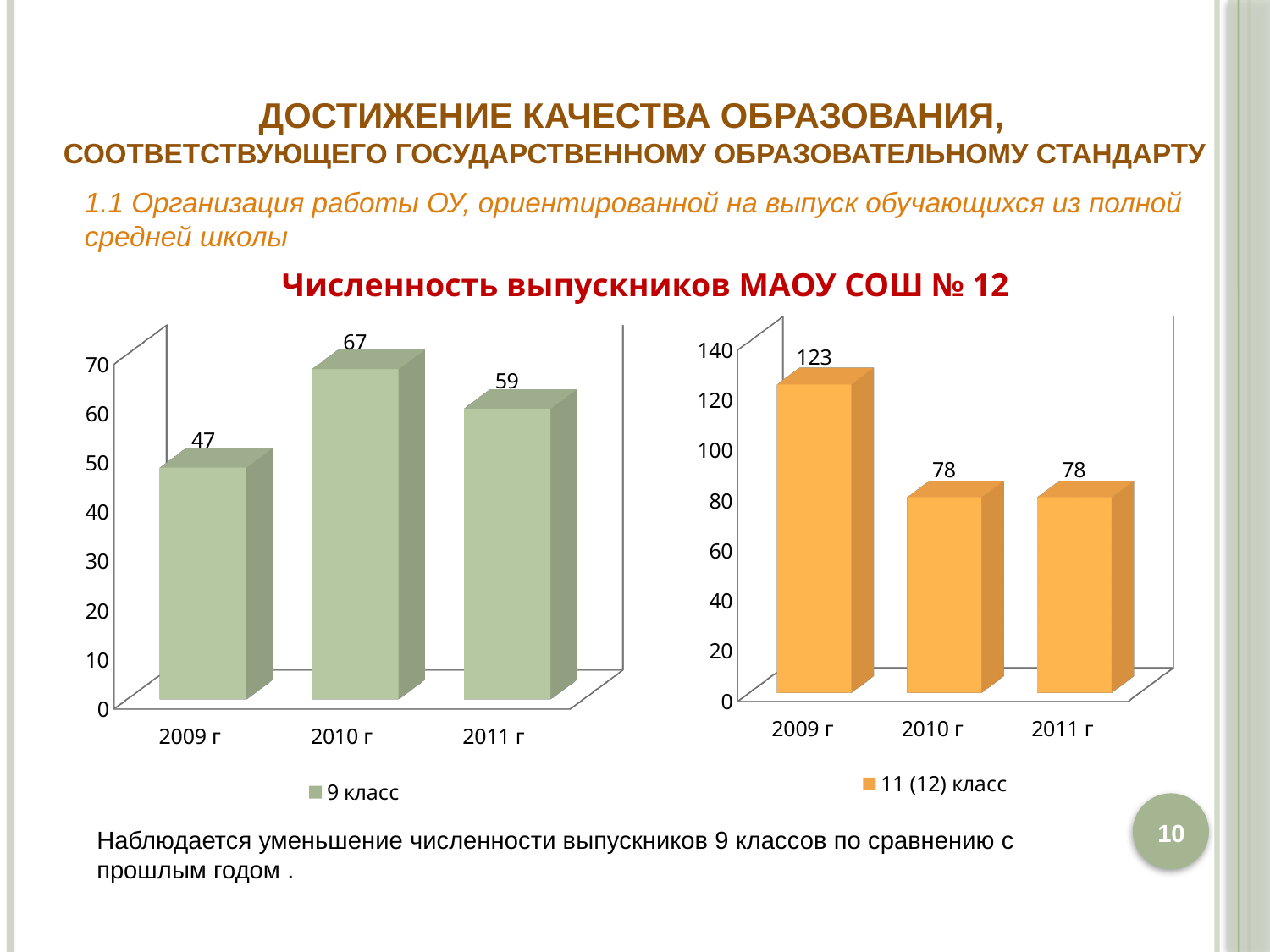
In the left chart (9 класс), which is larger: the value for 2009 г or the value for 2011 г? 2011 г How many years are shown on the x axis of the left chart (9 класс)? 3 In the left chart (9 класс), what is the difference between the values for 2010 г and 2011 г? 8 What is the legend entry of the right chart? 11 (12) класс In the right chart (11 (12) класс), is the value for 2011 г greater or less than 100? less In the left chart (9 класс), what is the value for 2010 г? 67 In the left chart (9 класс), which year has the lowest value? 2009 г What kind of chart is the left chart (9 класс)? bar chart In the right chart (11 (12) класс), which year has the highest value? 2009 г How many series does the legend of the right chart list? 1 In the right chart (11 (12) класс), what is the value for 2009 г? 123 In the right chart (11 (12) класс), what is the difference between the values for 2009 г and 2010 г? 45